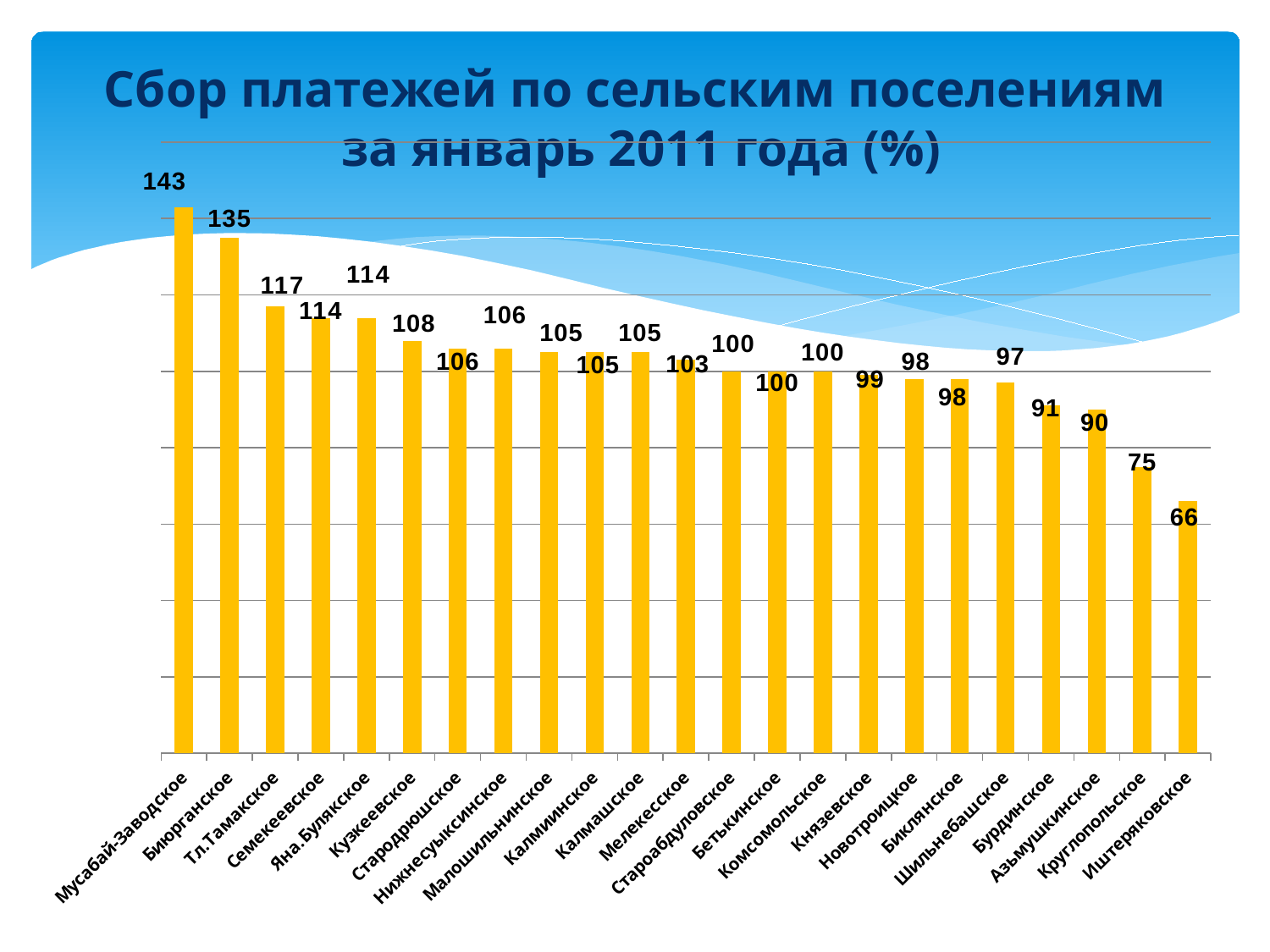
What is the value for Бурдинское? 91 Which settlement has the highest value? Мусабай-Заводское What is the value for Кузкеевское? 108 What is the difference between the values for Биюрганское and Тл.Тамакское? 18 Which is larger, the value for Азьмушкинское or the value for Круглопольское? Азьмушкинское What is the value for Круглопольское? 75 What is the difference between the values for Мусабай-Заводское and Иштеряковское? 77 Which settlement has the lowest value? Иштеряковское Do the values rise or fall from left to right along the x axis? Fall What is the value for Мусабай-Заводское? 143 How many settlements are shown on the chart? 23 What kind of chart is shown on the slide? Bar chart